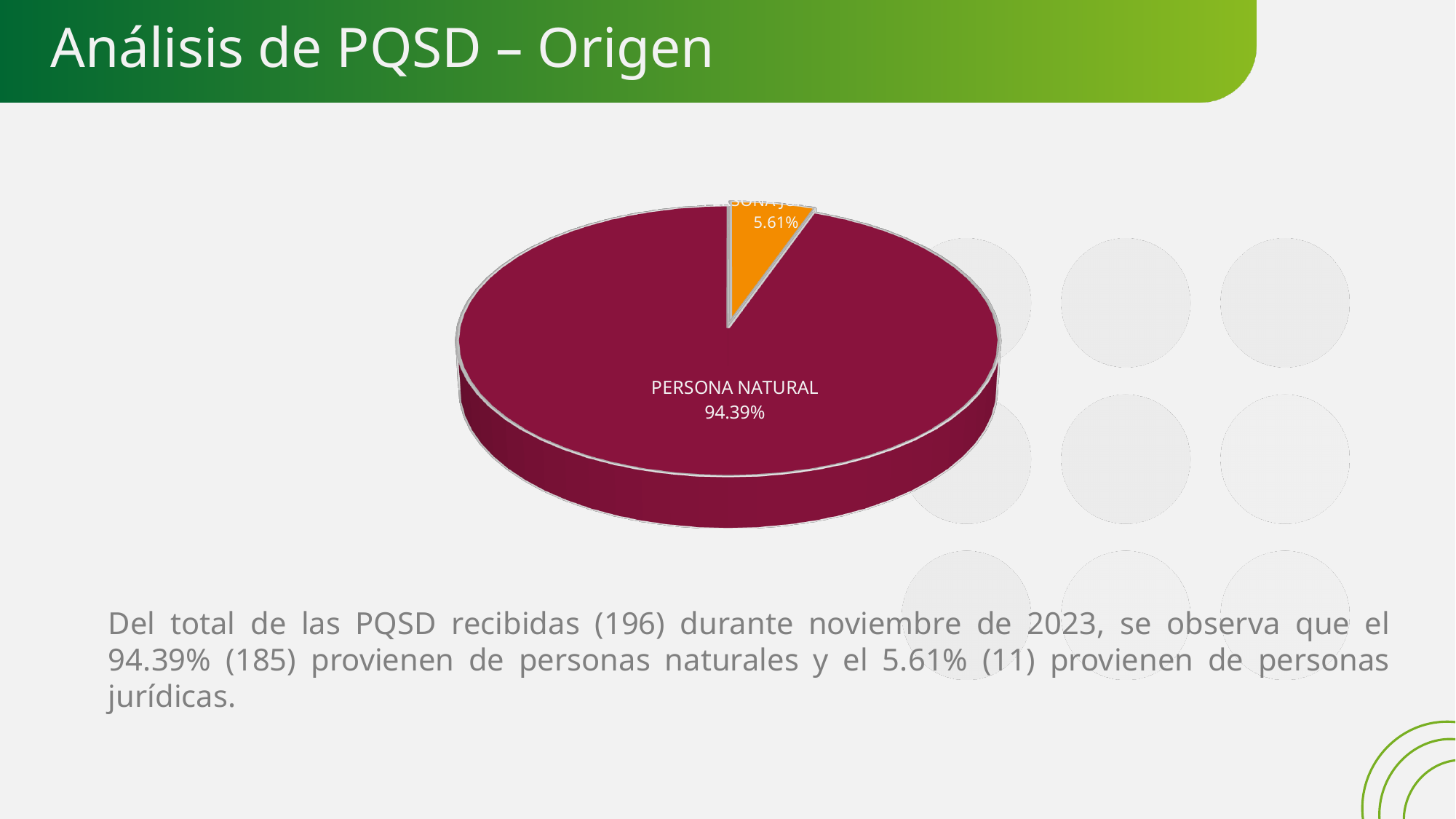
What colour is the smaller slice of the pie chart? Orange What share of the pie does PERSONA NATURAL represent? 94.39% What percentage does the PERSONA NATURAL slice show in the pie chart? 94.39% Which category has the largest share of the pie chart? PERSONA NATURAL What colour is the PERSONA NATURAL slice in the pie chart? Dark magenta (maroon) What do the two slices of the pie chart add up to? 100% What is the difference in percentage points between the PERSONA NATURAL slice and the orange slice? 88.78 percentage points What kind of chart is shown on the slide? Pie chart How many slices does the pie chart have? 2 What percentage is printed on the orange slice of the pie chart? 5.61% Which is larger in the pie chart: the PERSONA NATURAL slice or the orange slice? PERSONA NATURAL